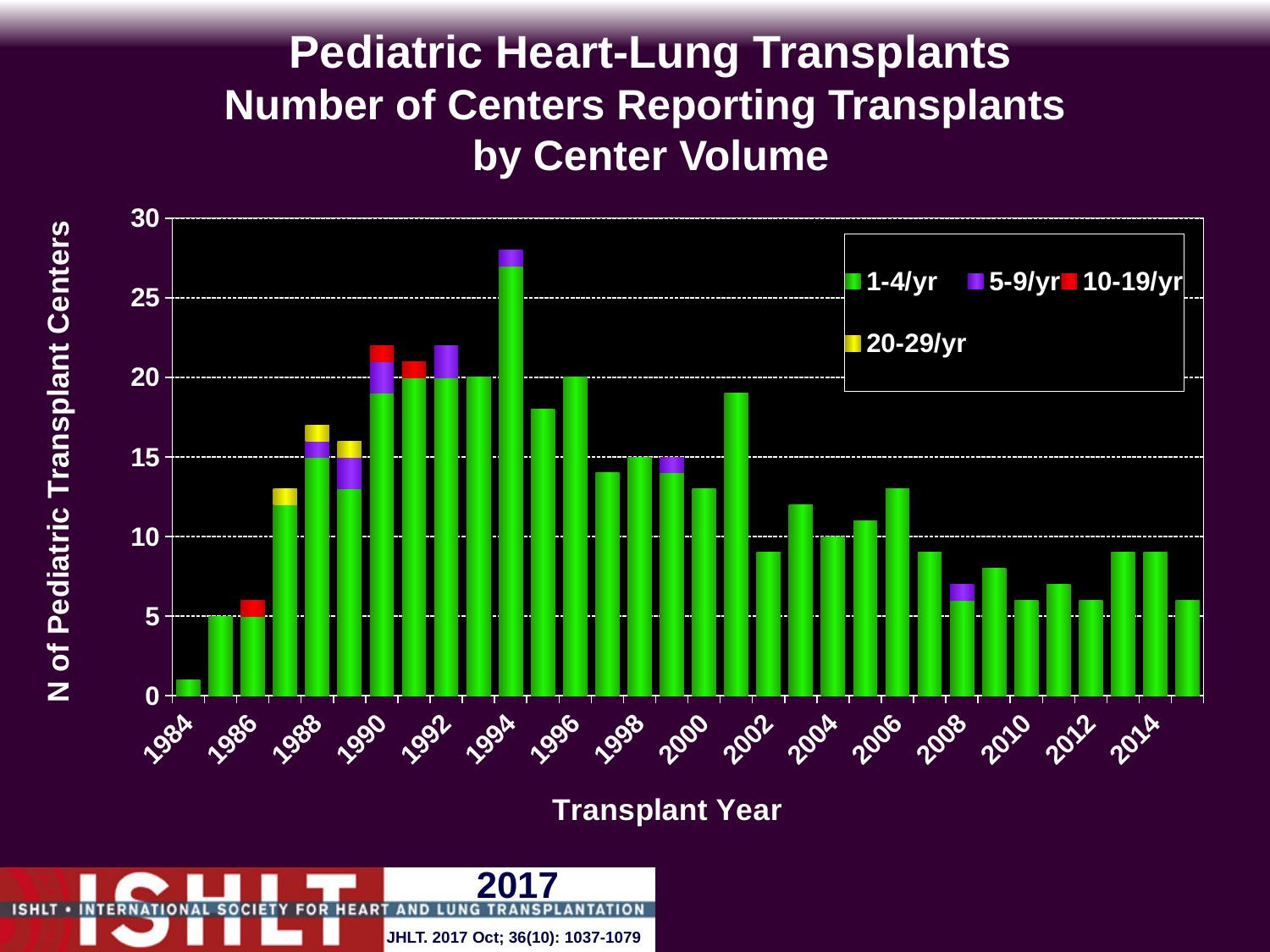
Is the total number of centers for 2002 greater or less than 10? less Which transplant year has the highest total number of pediatric transplant centers? 1994 Which year has more reporting centers in total, 1994 or 2014? 1994 What type of chart is shown on the slide? Stacked bar chart Is the total number of centers for 1994 greater or less than 25? greater Which transplant year has the lowest total number of pediatric transplant centers? 1984 What is the label of the y axis? N of Pediatric Transplant Centers Is the total number of centers for 1990 greater or less than 20? greater How many pediatric transplant centers are shown for 1996? 20 From 1994 to 2015, do the total numbers of reporting centers generally rise or fall? fall Which center-volume category is shown in green in the legend? 1-4/yr How many series does the legend list? 4